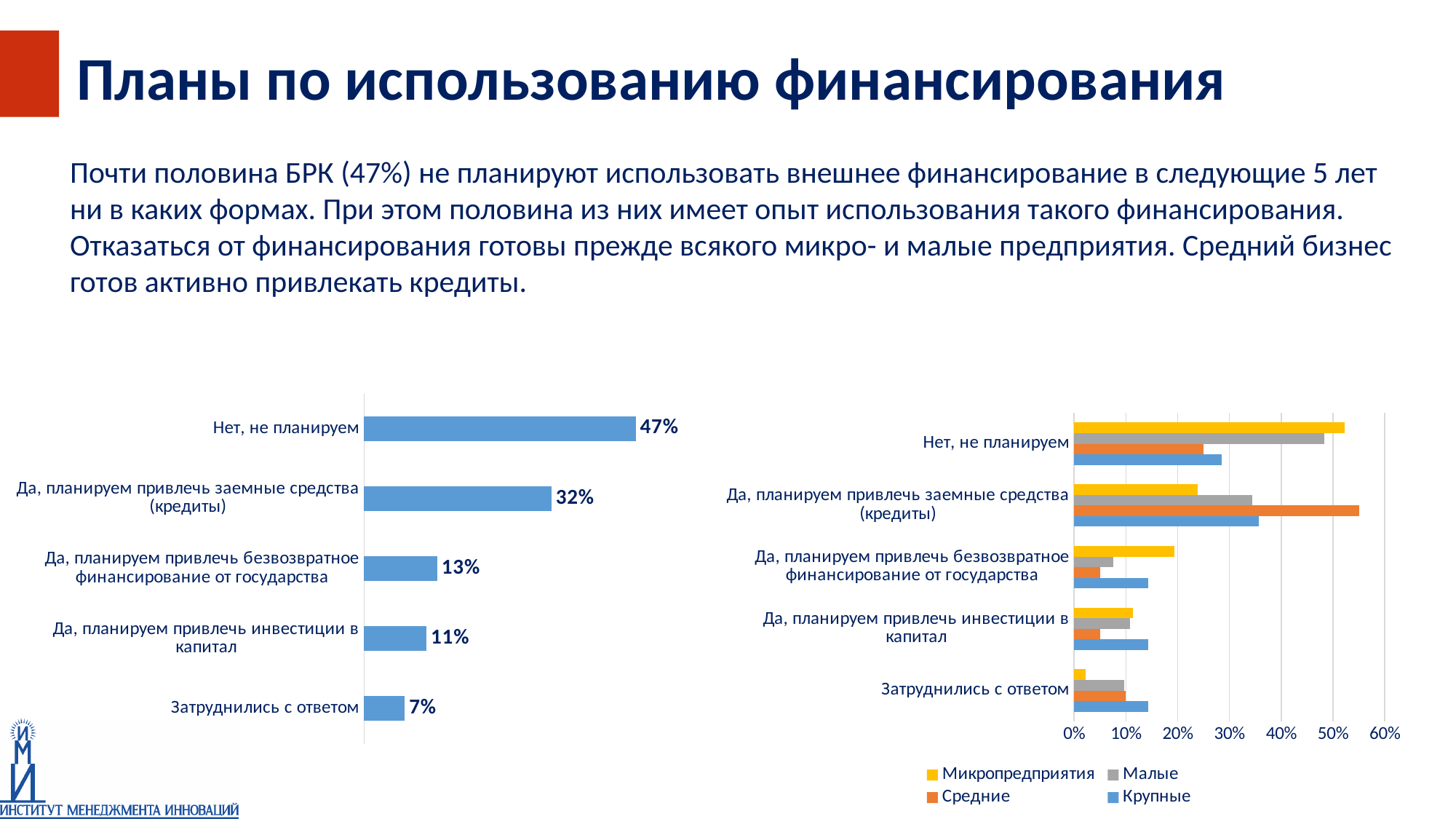
How many series does the legend of the right chart list? 4 In the right chart, for "Нет, не планируем", which is larger: "Микропредприятия" or "Средние"? Микропредприятия In the left chart, which category has the lowest value? Затруднились с ответом In the right chart, is the value for "Средние" in "Да, планируем привлечь заемные средства (кредиты)" greater or less than 50%? greater In the left chart, which is larger: "Да, планируем привлечь безвозвратное финансирование от государства" or "Да, планируем привлечь инвестиции в капитал"? Да, планируем привлечь безвозвратное финансирование от государства What kind of chart is the left chart? Bar chart In the left chart, which category has the highest value? Нет, не планируем In the left chart, what is the value for "Нет, не планируем"? 47% In the right chart, is the value for "Микропредприятия" in "Затруднились с ответом" greater or less than 10%? less How many categories does the left chart show? 5 In the left chart, what is the difference between "Нет, не планируем" and "Да, планируем привлечь заемные средства (кредиты)"? 15% In the left chart, what is the value for "Да, планируем привлечь инвестиции в капитал"? 11%